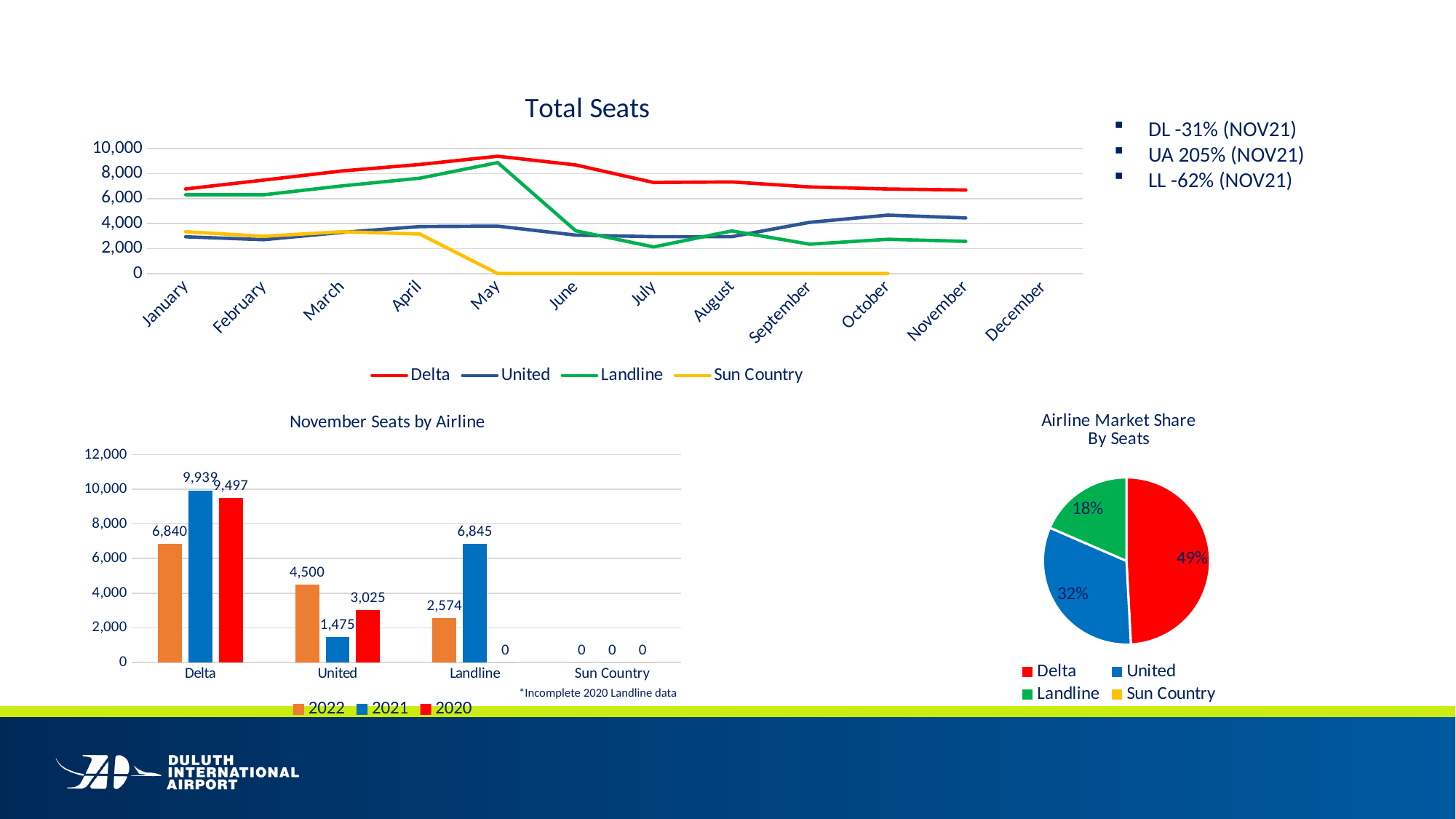
In the November Seats by Airline chart, which is larger for United: the 2022 value or the 2020 value? 2022 In the November Seats by Airline chart, which airline has the highest 2021 value? Delta In the Airline Market Share By Seats pie chart, what share does United have? 32% In the November Seats by Airline chart, what is the 2020 value for United? 3,025 In the November Seats by Airline chart, what is the 2021 value for Landline? 6,845 What kind of chart is the Total Seats chart? Line chart How many series does the legend of the November Seats by Airline chart list? 3 In the Total Seats chart, is the Landline value for May greater or less than 8,000? greater In the November Seats by Airline chart, what is the difference between Delta's 2021 and 2022 values? 3,099 In the Airline Market Share By Seats pie chart, which airline has the largest slice? Delta How many series does the legend of the Total Seats chart list? 4 In the November Seats by Airline chart, what is the 2022 value for Delta? 6,840